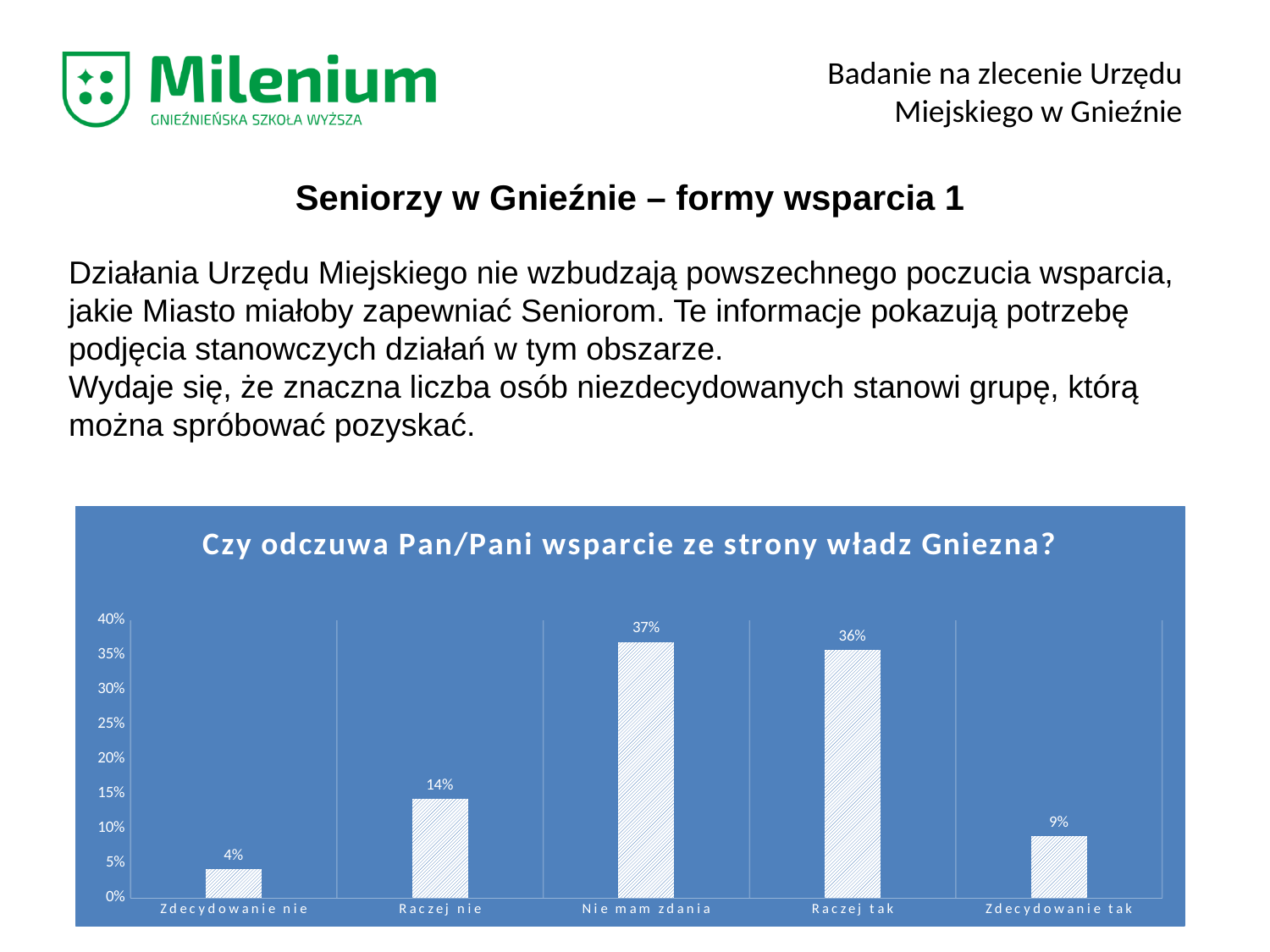
What is the difference between the values for "Raczej nie" and "Zdecydowanie tak"? 5% Which is larger, the value for "Raczej nie" or the value for "Zdecydowanie tak"? Raczej nie What is the value for "Zdecydowanie nie"? 4% What kind of chart is shown on the slide? bar chart What is the value for "Zdecydowanie tak"? 9% What is the value for "Nie mam zdania"? 37% How many categories are shown on the x axis? 5 What is the value for "Raczej tak"? 36% What is the title of the chart? Czy odczuwa Pan/Pani wsparcie ze strony władz Gniezna? Which category has the lowest value? Zdecydowanie nie Is the value for "Raczej tak" greater or less than 30%? greater Which category has the highest value? Nie mam zdania